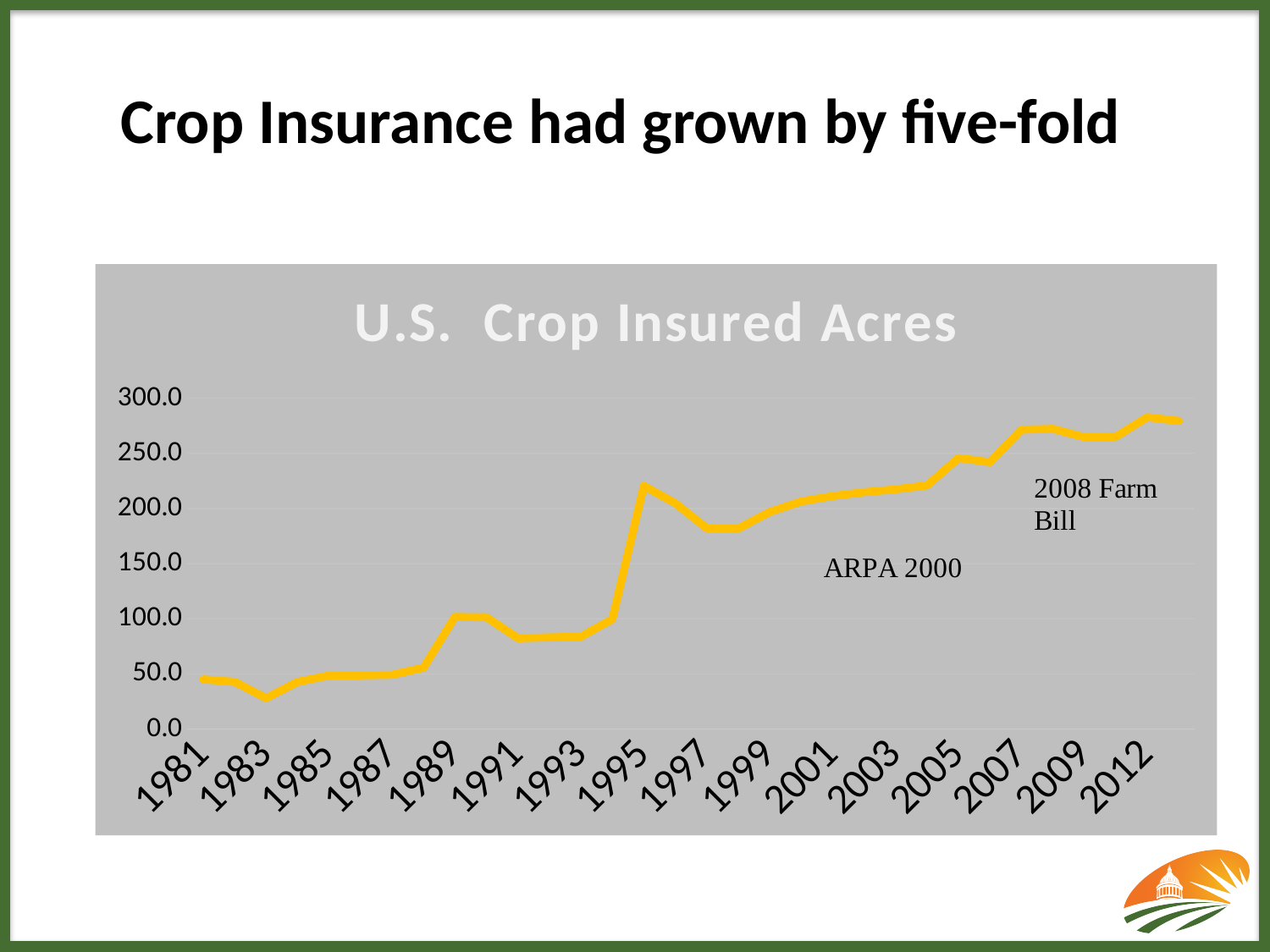
Is the value for 2012 greater or less than 250? greater What kind of chart is shown on the slide? line chart Which year has the lowest value on the chart? 1983 Is the value for 1995 greater or less than 200? greater Is the value for 1983 greater or less than 50? less What is the title of the chart? U.S. Crop Insured Acres Overall, do the values rise or fall from 1981 to 2012? rise Which year has the larger value, 2005 or 2007? 2007 Which year has the larger value, 1995 or 1997? 1995 What two policy events are annotated on the chart? ARPA 2000 and 2008 Farm Bill